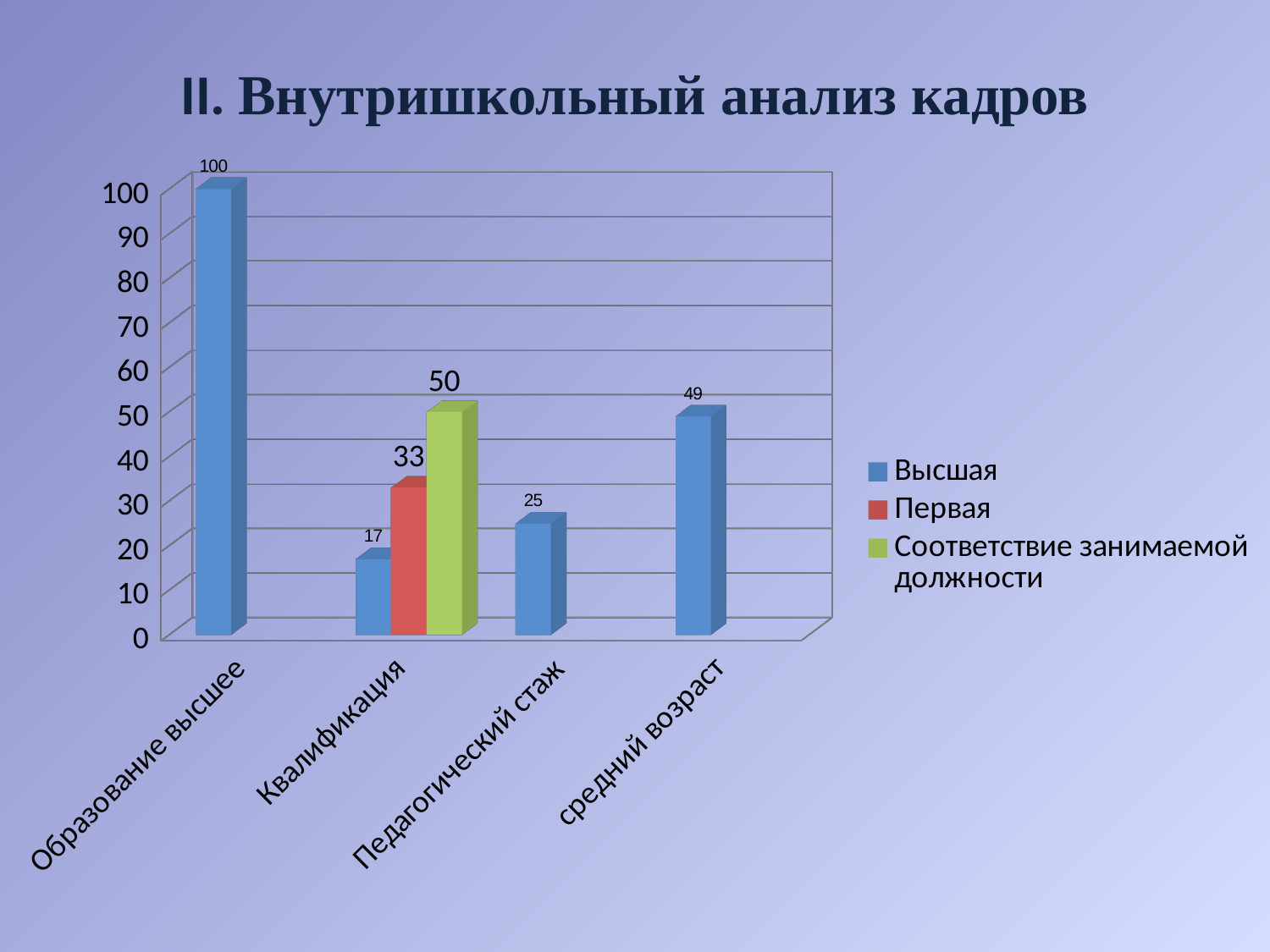
What is the value of the Высшая series for Образование высшее? 100 Which is larger for Квалификация: the Высшая value or the Первая value? Первая How many categories are shown on the x axis? 4 What is the value of the Соответствие занимаемой должности series for Квалификация? 50 Which category has the lowest value in the Высшая series? Квалификация What is the value of the Высшая series for средний возраст? 49 What is the value of the Высшая series for Педагогический стаж? 25 How many series does the legend list? 3 What is the value of the Первая series for Квалификация? 33 Which category has the highest value in the Высшая series? Образование высшее What kind of chart is shown on the slide? bar chart What is the difference between the Соответствие занимаемой должности value and the Первая value for Квалификация? 17